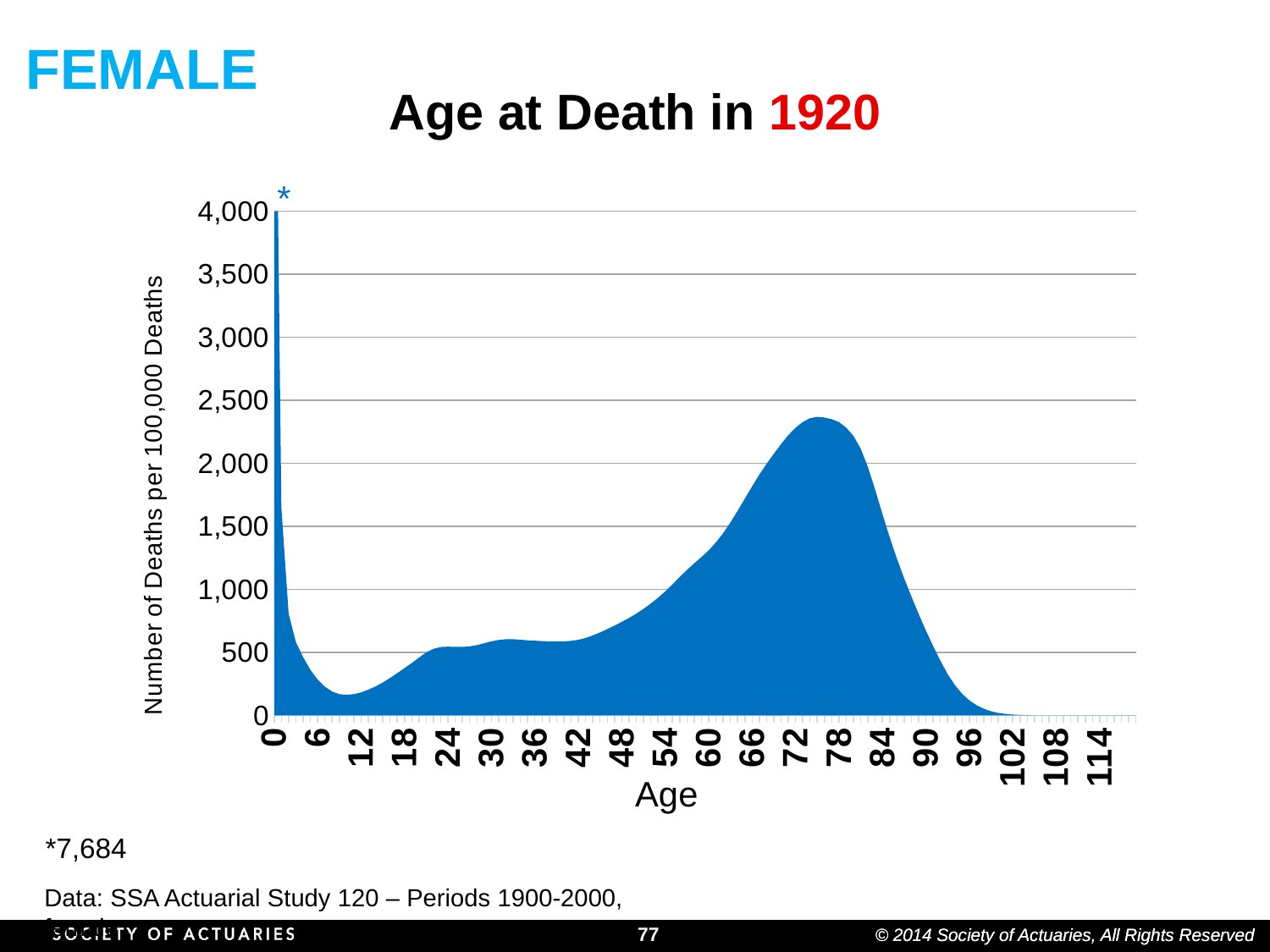
Between ages 78 and 96, do the values rise or fall as age increases? fall Is the value at age 12 greater or less than 500? less Is the value at age 72 greater or less than 2,000? greater What kind of chart is shown on the slide? area chart What is the number of deaths per 100,000 deaths at age 0, as given by the asterisk footnote? 7,684 Which age has a higher number of deaths per 100,000 deaths, age 30 or age 72? age 72 Is the value at age 60 greater or less than 1,000? greater What is the label of the vertical axis? Number of Deaths per 100,000 Deaths At which age is the number of deaths per 100,000 deaths highest? 0 Which age has a higher number of deaths per 100,000 deaths, age 60 or age 90? age 60